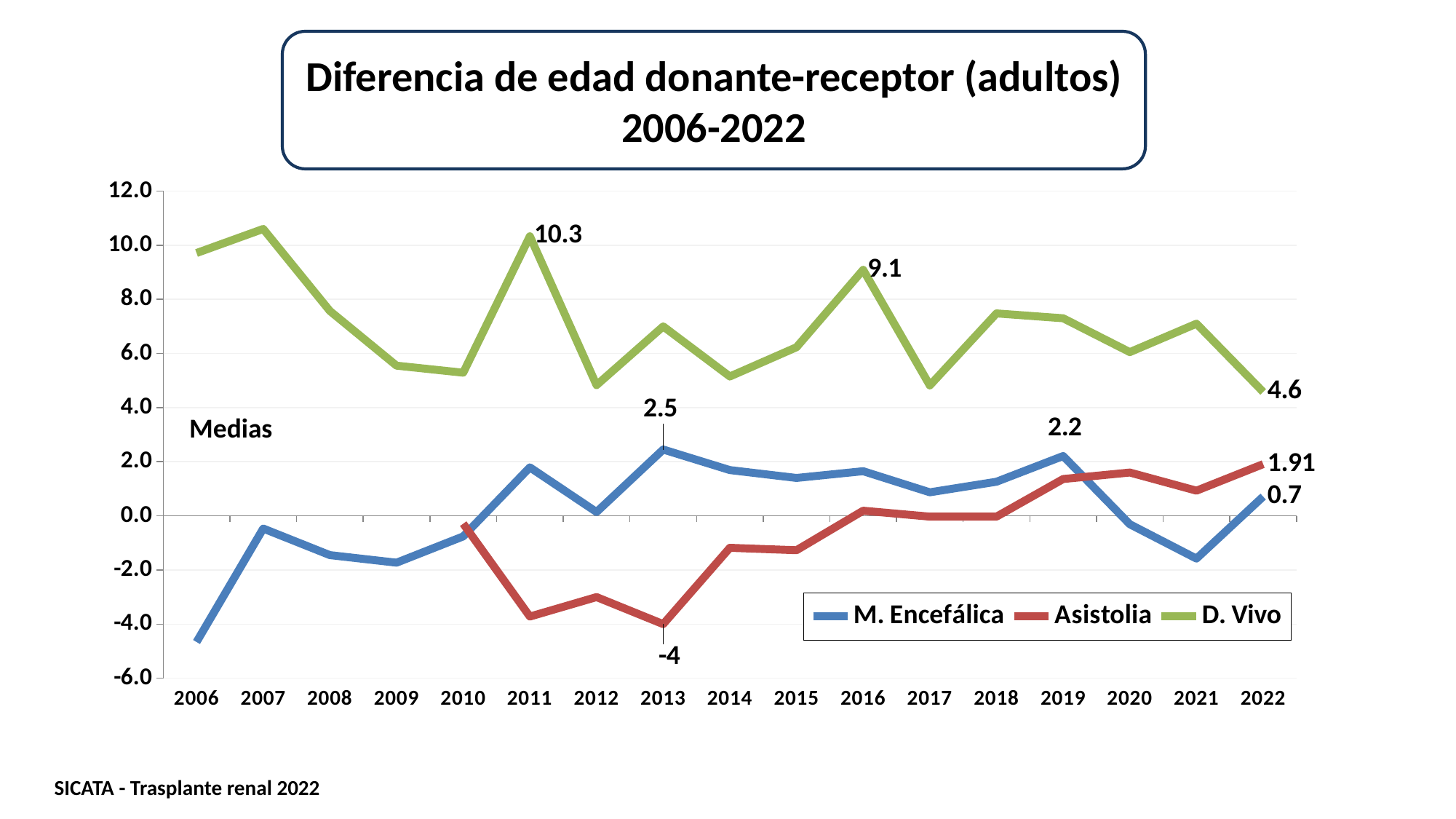
What is the value for D. Vivo in 2011? 10.3 Is the value for D. Vivo in 2006 greater or less than 8.0? greater What is the value for M. Encefálica in 2019? 2.2 How many years are plotted along the x axis? 17 What is the value for M. Encefálica in 2013? 2.5 What is the value for D. Vivo in 2022? 4.6 How many series does the legend list? 3 What is the value for Asistolia in 2022? 1.91 In 2022, which is larger: the value for Asistolia or the value for M. Encefálica? Asistolia What is the difference between the D. Vivo values in 2011 and 2016? 1.2 What is the value for Asistolia in 2013? -4 What kind of chart is shown on the slide? Line chart